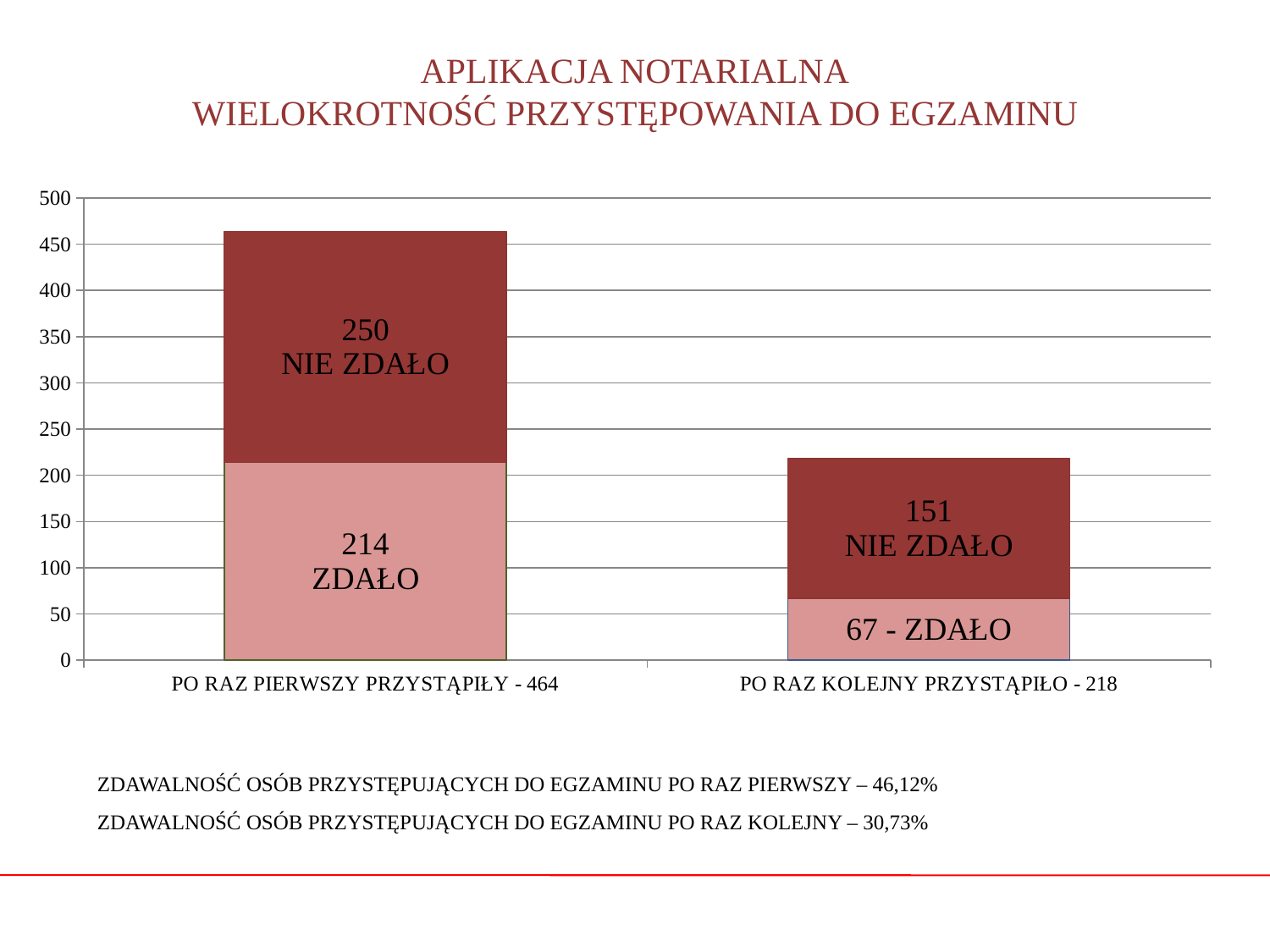
How many categories are shown on the x axis? 2 What kind of chart is shown on the slide? stacked bar chart Which category has the higher total: PO RAZ PIERWSZY PRZYSTĄPIŁY or PO RAZ KOLEJNY PRZYSTĄPIŁO? PO RAZ PIERWSZY PRZYSTĄPIŁY How many people did not pass (NIE ZDAŁO) among those taking the exam for the first time? 250 What is the title of the chart? APLIKACJA NOTARIALNA WIELOKROTNOŚĆ PRZYSTĘPOWANIA DO EGZAMINU What is the total of the stacked bar for PO RAZ KOLEJNY PRZYSTĄPIŁO? 218 How many people did not pass (NIE ZDAŁO) among those taking the exam again? 151 Is the total for PO RAZ KOLEJNY PRZYSTĄPIŁO greater or less than 250? less How many people passed (ZDAŁO) among those taking the exam again (PO RAZ KOLEJNY PRZYSTĄPIŁO)? 67 How many people passed (ZDAŁO) among those taking the exam for the first time (PO RAZ PIERWSZY PRZYSTĄPIŁY)? 214 What is the total of the stacked bar for PO RAZ PIERWSZY PRZYSTĄPIŁY? 464 What is the difference between the number who did not pass on the first attempt (250) and the number who did not pass on a repeat attempt (151)? 99